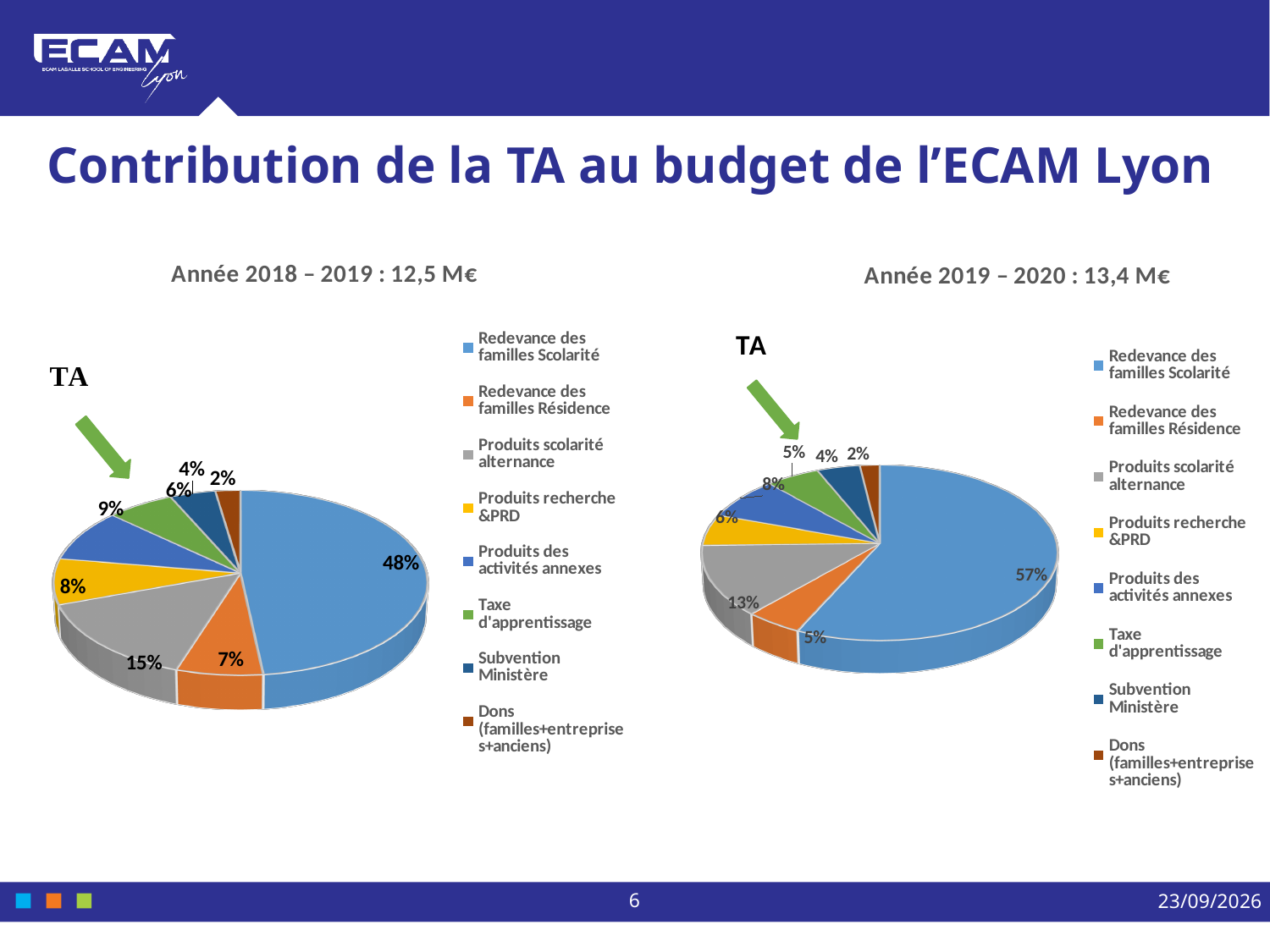
How many categories does the legend of the 'Année 2019 – 2020 : 13,4 M€' pie chart list? 8 In the 'Année 2019 – 2020 : 13,4 M€' pie chart, what share is labelled for Produits scolarité alternance? 13% What is the difference between the Redevance des familles Scolarité share in the 2019 – 2020 chart and in the 2018 – 2019 chart? 9 percentage points In the 'Année 2018 – 2019 : 12,5 M€' pie chart, which is larger: Produits des activités annexes or Produits recherche &PRD? Produits des activités annexes In the 'Année 2019 – 2020 : 13,4 M€' pie chart, what share is labelled for Redevance des familles Scolarité? 57% In the 'Année 2018 – 2019 : 12,5 M€' pie chart, which category has the largest slice? Redevance des familles Scolarité In the 'Année 2019 – 2020 : 13,4 M€' pie chart, which category has the smallest slice? Dons (familles+entreprises+anciens) In the 'Année 2019 – 2020 : 13,4 M€' pie chart, what share is labelled for Taxe d'apprentissage? 5% In the 'Année 2018 – 2019 : 12,5 M€' pie chart, what share is labelled for Taxe d'apprentissage? 6% In the 'Année 2018 – 2019 : 12,5 M€' pie chart, what share is labelled for Produits scolarité alternance? 15% What type of chart is used on this slide? Pie chart In the 'Année 2018 – 2019 : 12,5 M€' pie chart, what share is labelled for Redevance des familles Scolarité? 48%